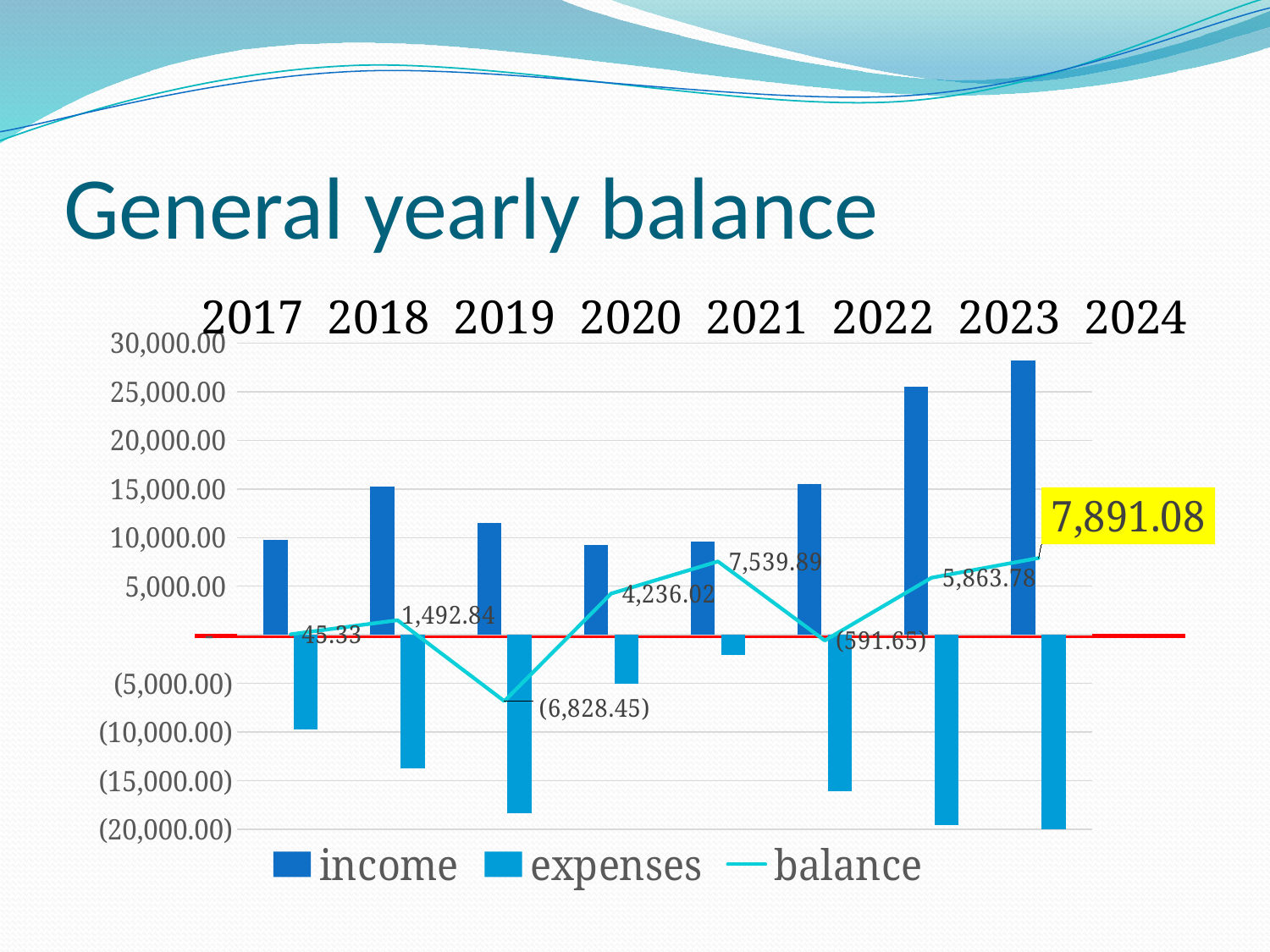
Which year has the larger balance, 2018 or 2020? 2020 What is the balance value shown for 2024? 7,891.08 How many years are shown on the x axis? 8 Which year has the highest income bar? 2024 Which year has the lowest balance? 2019 How many series does the legend list? 3 What is the balance value shown for 2021? 7,539.89 Which year has the highest balance? 2024 What is the balance value shown for 2019? (6,828.45) What is the difference between the balance in 2024 and the balance in 2023? 2,027.30